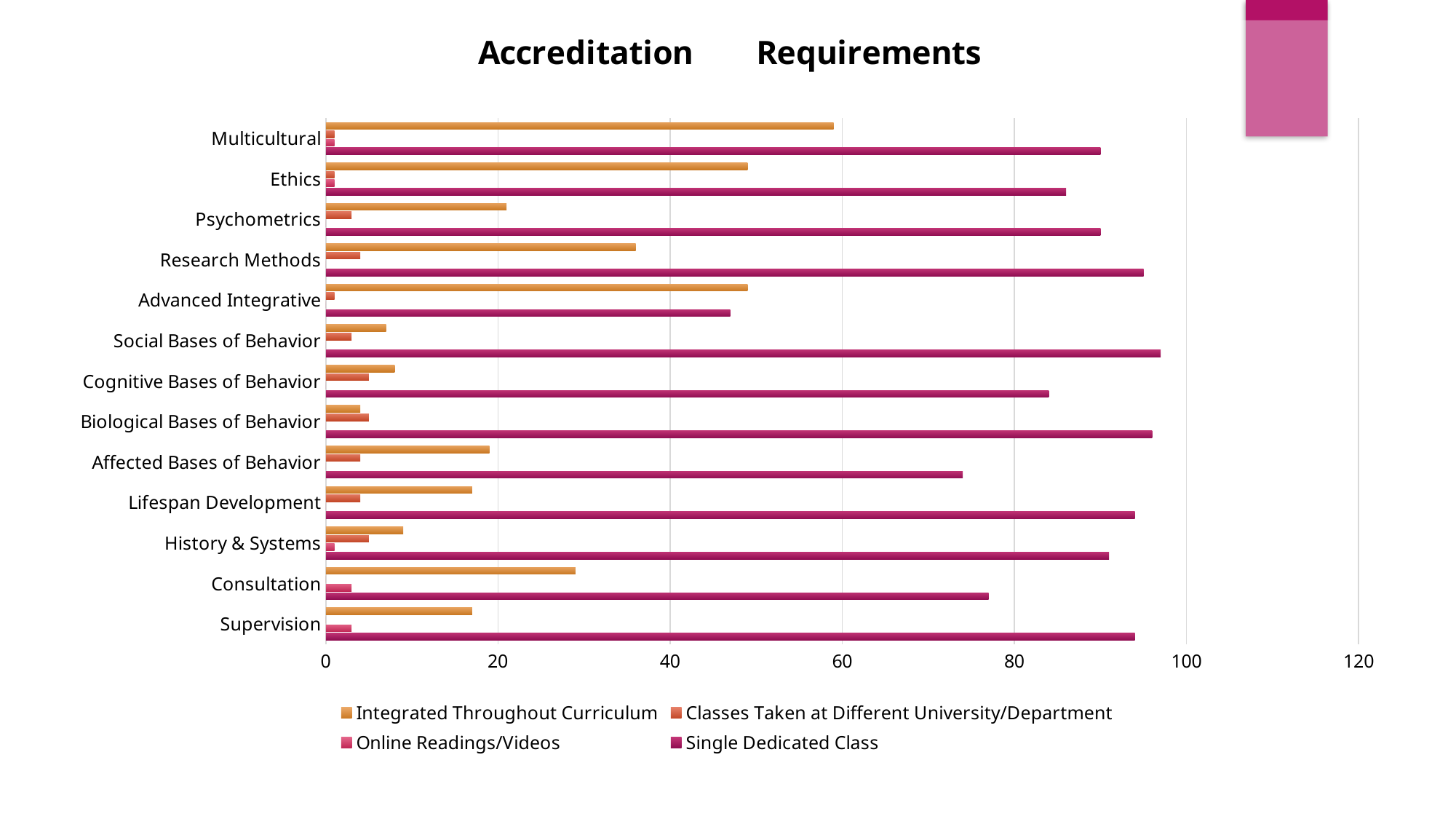
How many series does the chart's legend list? 4 What is the title of the chart? Accreditation Requirements Is the Integrated Throughout Curriculum value for Consultation greater or less than 20? greater Which category has the highest value for the Integrated Throughout Curriculum series? Multicultural For the Integrated Throughout Curriculum series, which is larger: Multicultural or Psychometrics? Multicultural How many categories are listed on the vertical axis of the chart? 13 Is the Single Dedicated Class value for Affected Bases of Behavior greater or less than 80? less Is the Single Dedicated Class value for Advanced Integrative greater or less than 60? less For the Single Dedicated Class series, which is larger: Consultation or Supervision? Supervision What kind of chart is shown on the slide? bar chart Which category has the lowest value for the Single Dedicated Class series? Advanced Integrative